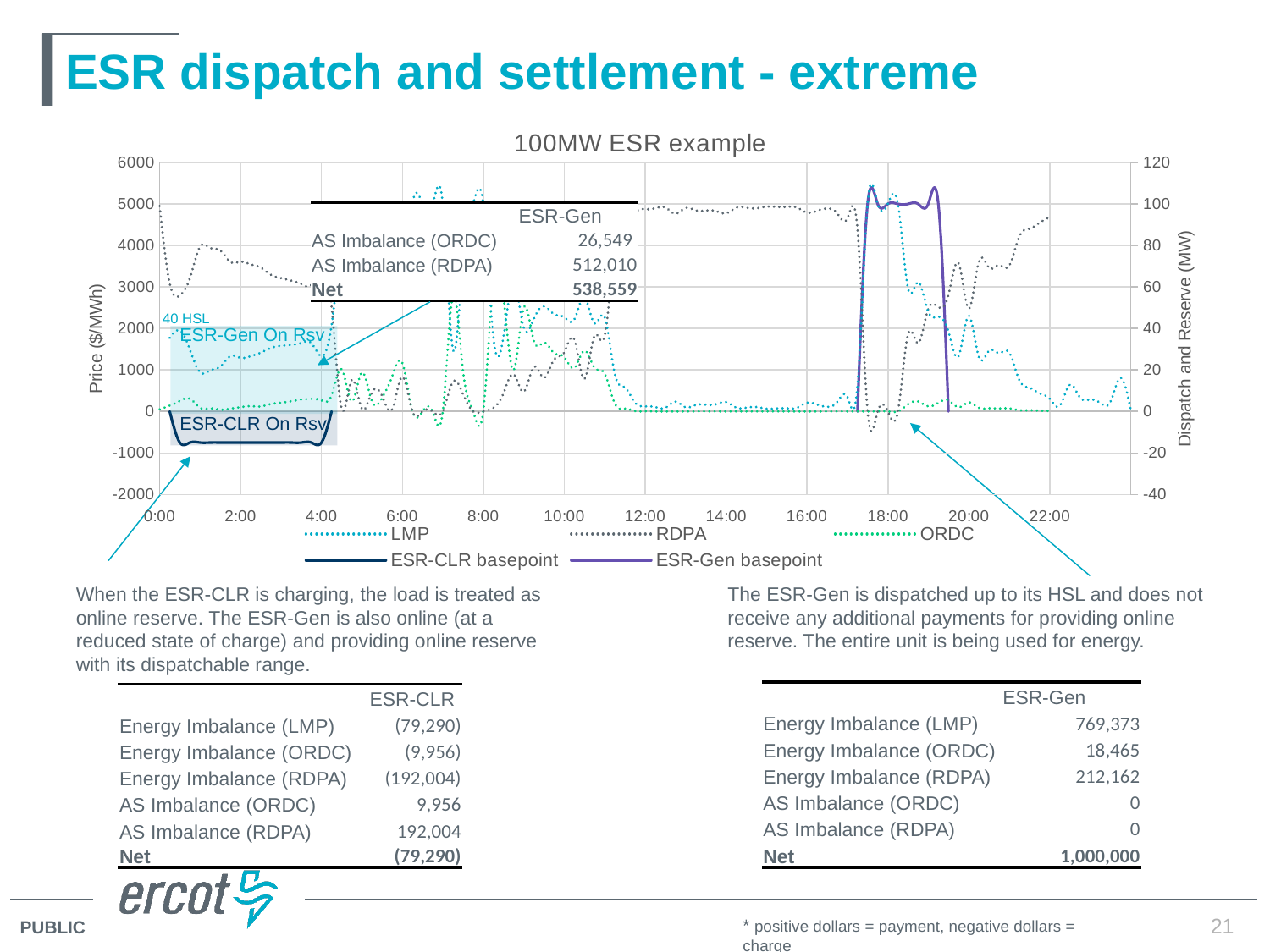
What kind of chart is shown on the slide? line chart What is the label of the right-hand vertical axis of the chart? Dispatch and Reserve (MW) Is the ESR-Gen basepoint value at 18:00 greater or less than 80 on the right-hand axis? greater Does the ESR-Gen basepoint rise or fall between 17:00 and 18:00? rise How many series does the chart legend list? 5 What is the title of the chart? 100MW ESR example Does the ESR-Gen basepoint rise or fall between 19:00 and 20:00? fall